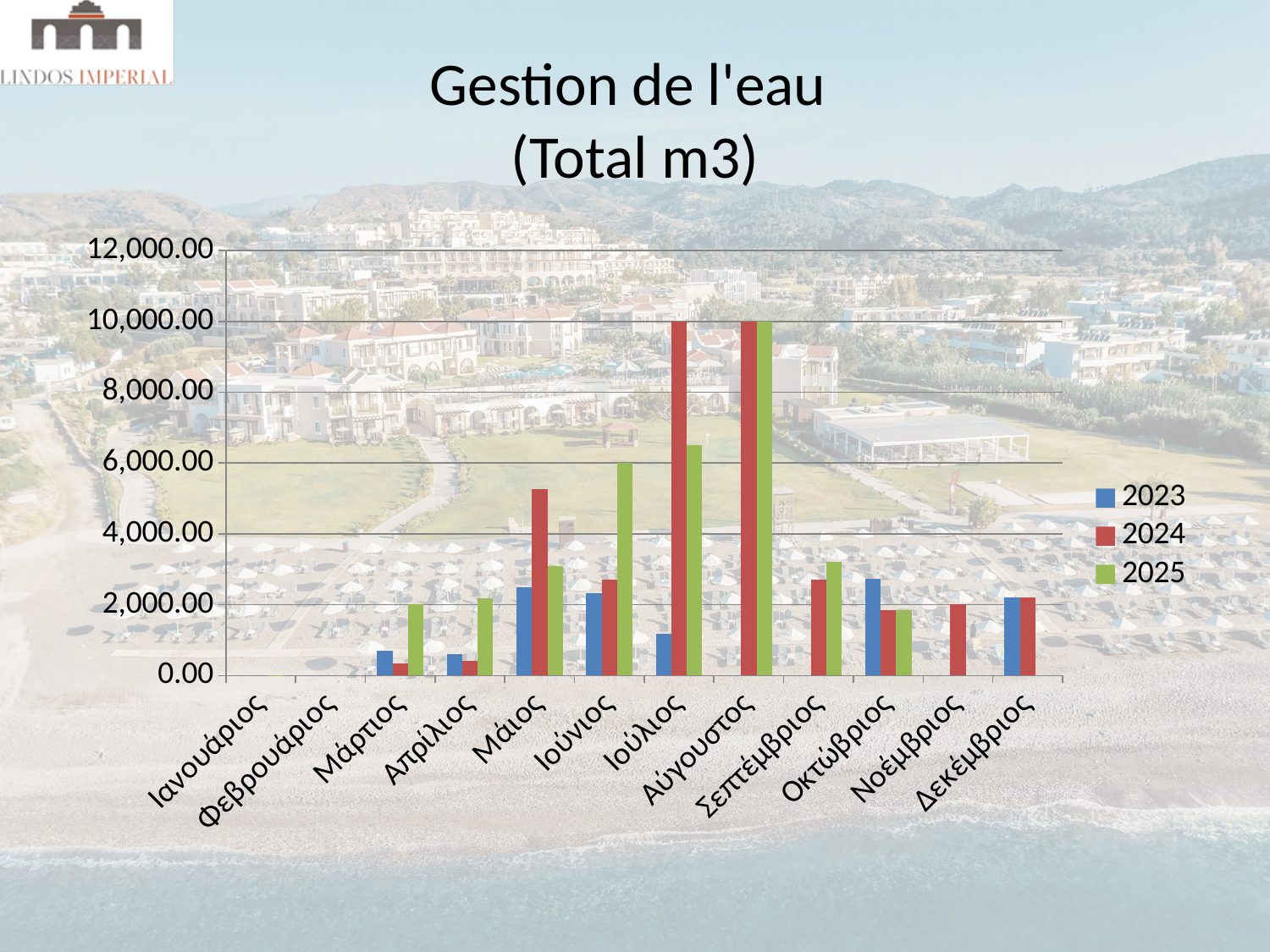
Which month has the highest value for the 2025 series? Αύγουστος What kind of chart is shown on the slide? bar chart Is the 2023 value for Ιούλιος greater or less than 2,000.00? less How many months (categories) are shown on the x axis? 12 Is the 2023 value for Μάιος greater or less than 4,000.00? less For Μάρτιος, which year has the larger value, 2024 or 2025? 2025 Which years are listed in the legend? 2023, 2024, 2025 Is the 2024 value for Ιούλιος greater or less than 8,000.00? greater What is the title of the chart? Gestion de l'eau (Total m3) How many series does the legend list? 3 For Ιούλιος, which year has the larger value, 2024 or 2025? 2024